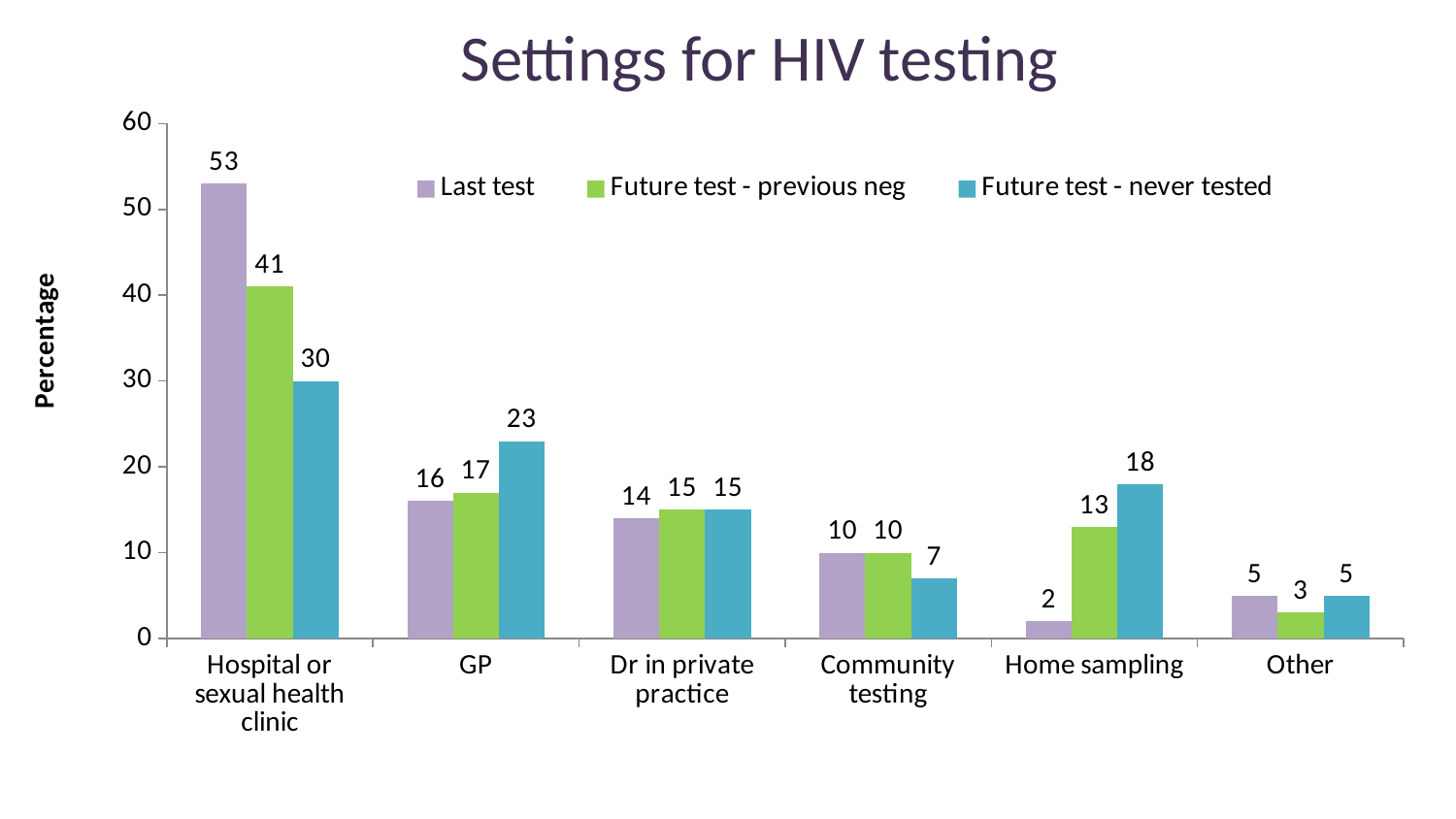
What is the difference between Last test and Future test - never tested at Hospital or sexual health clinic? 23 How many series does the legend list? 3 How many categories are shown on the x axis? 6 Which is larger at Home sampling: Last test or Future test - never tested? Future test - never tested What is the value for Future test - never tested at GP? 23 What kind of chart is shown? bar chart What is the title of the chart? Settings for HIV testing What is the value for Future test - previous neg at Home sampling? 13 What is the value for Last test at Hospital or sexual health clinic? 53 Which category has the lowest value for Last test? Home sampling Which category has the highest value for Last test? Hospital or sexual health clinic Is the value for Future test - previous neg at Hospital or sexual health clinic greater or less than 40? greater